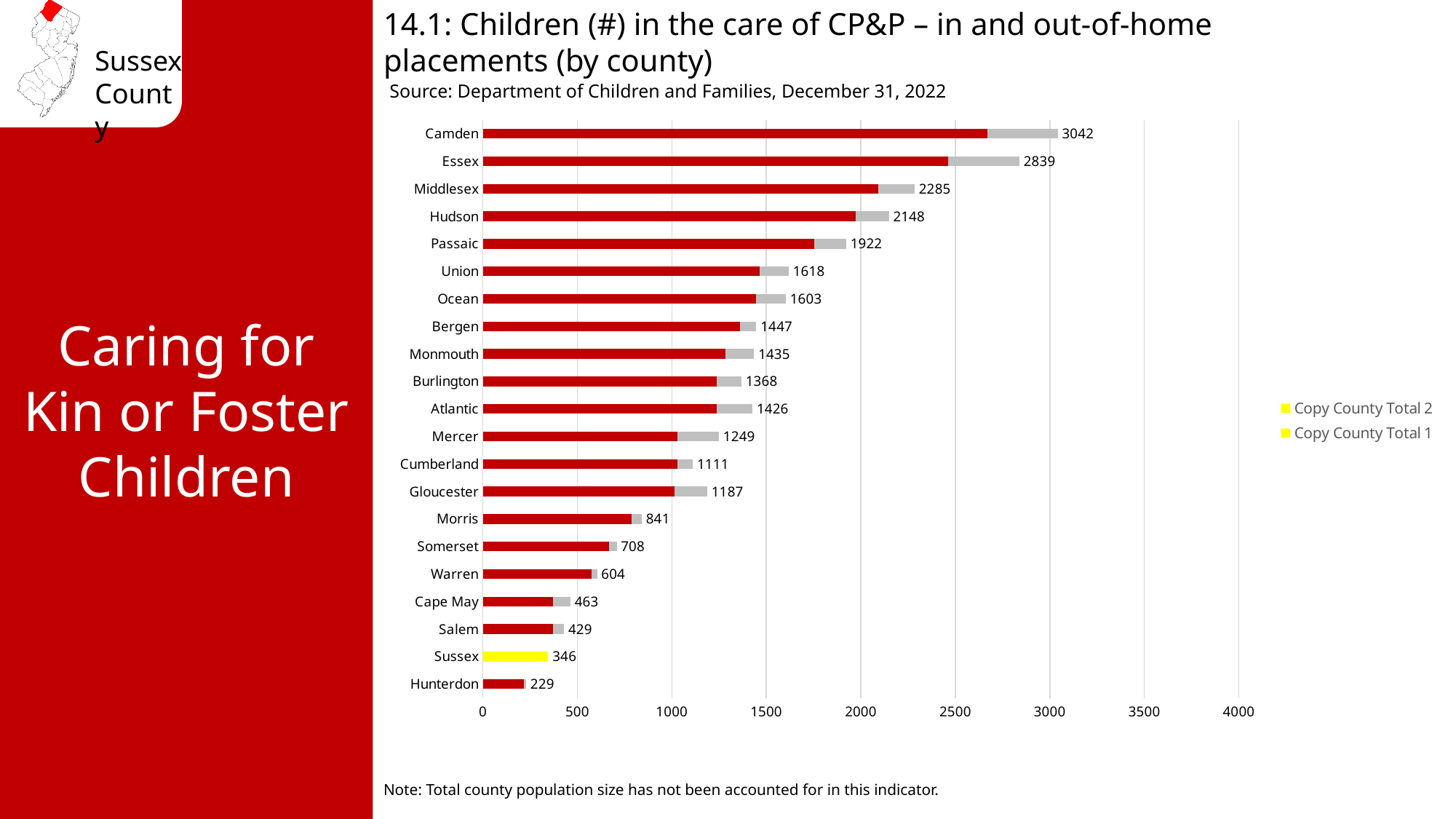
What is the total value shown for Sussex? 346 Is the red segment of the Camden bar greater or less than 2500? greater What is the total number of children in the care of CP&P for Camden? 3042 How many counties are shown on the chart? 21 What kind of chart is shown on the slide? Bar chart Which county has the lowest total? Hunterdon What is the difference between the totals for Sussex and Hunterdon? 117 What is the total value shown for Gloucester? 1187 How many entries does the legend list? 2 Which has a larger total, Atlantic or Burlington? Atlantic What is the difference between the totals for Camden and Essex? 203 Which county has the highest total? Camden